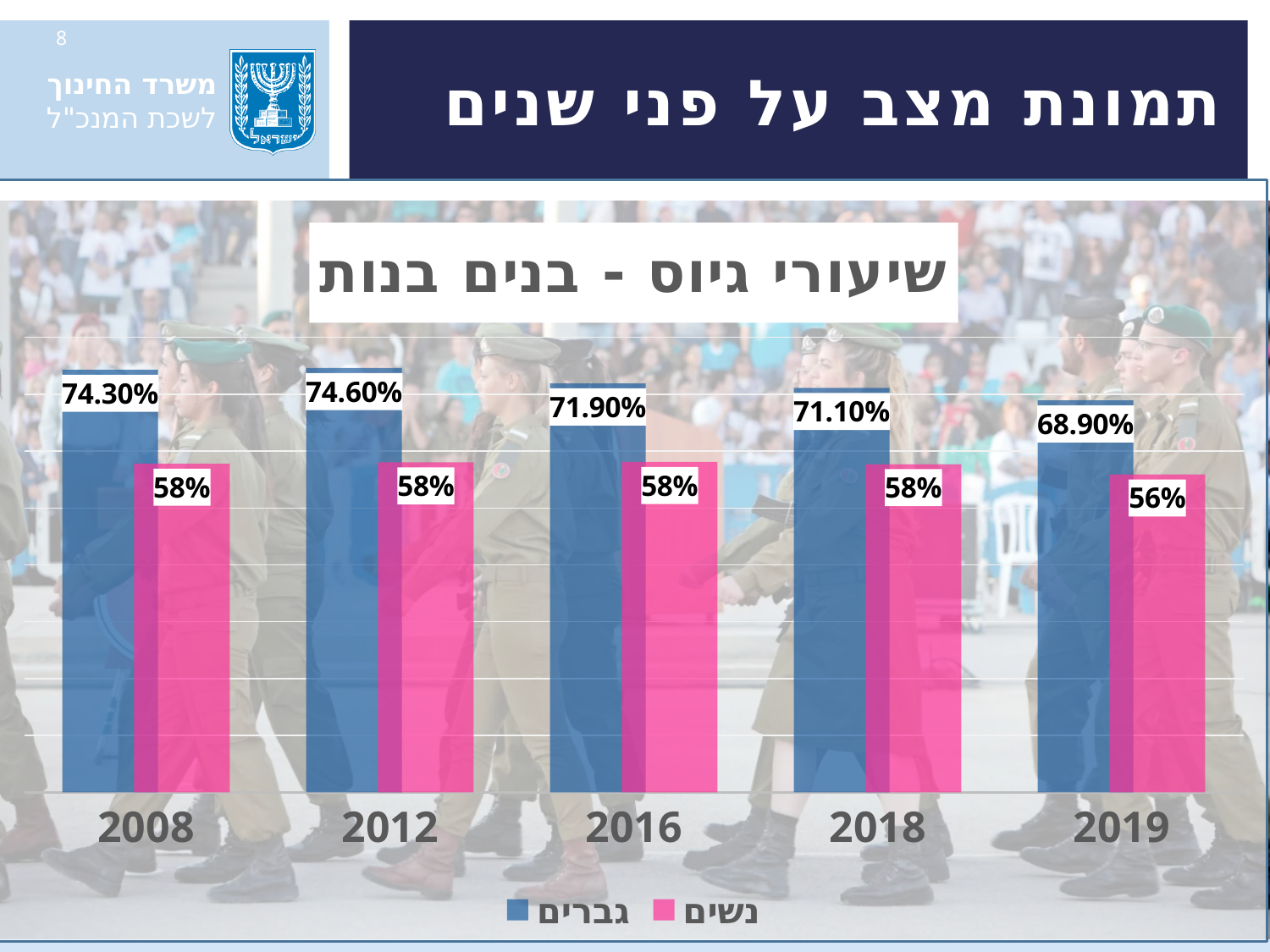
What is the difference between the גברים (men) and נשים (women) rates in 2018? 13.10% What is the value for גברים (men) in 2016? 71.90% What is the enlistment rate for גברים (men) in 2008? 74.30% How many years are shown on the x axis of the chart? 5 What is the enlistment rate for נשים (women) in 2019? 56% How many series does the legend list? 2 In which year is the גברים (men) enlistment rate lowest? 2019 What is the title of the chart? שיעורי גיוס - בנים בנות Does the גברים (men) enlistment rate rise or fall from 2012 to 2019? Fall Which is larger in 2019: the rate for גברים (men) or for נשים (women)? גברים (men) What kind of chart is shown on the slide? Bar chart In which year is the גברים (men) enlistment rate highest? 2012